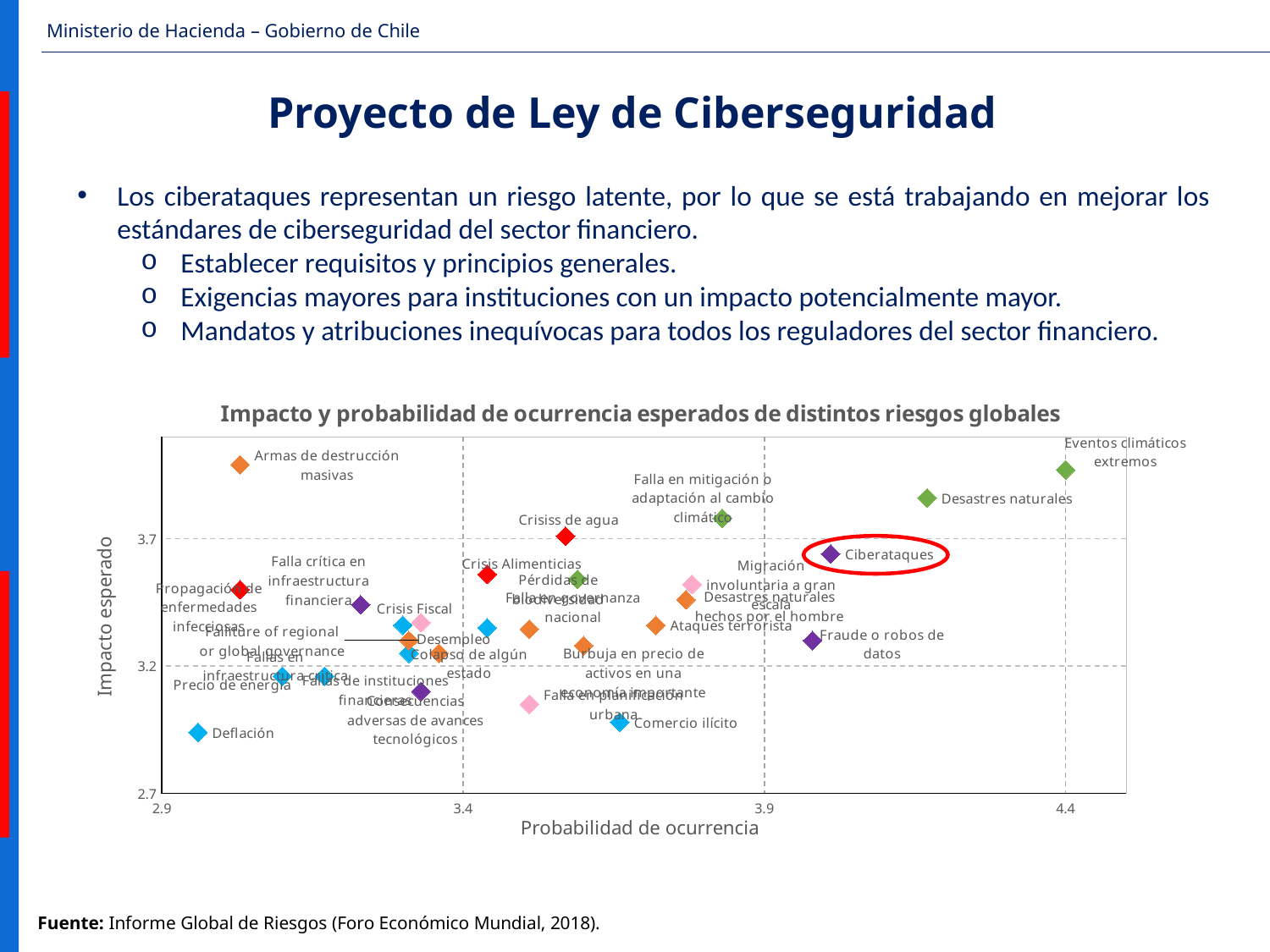
Is the probability of occurrence for Ciberataques greater or less than 3.9? greater What kind of chart is shown on the slide? Scatter chart Is the expected impact for Ciberataques greater or less than 3.7? less Which has a higher expected impact, Ciberataques or Deflación? Ciberataques Which risk has the highest probability of occurrence (Probabilidad de ocurrencia) in the chart? Eventos climáticos extremos Is the expected impact for Desastres naturales greater or less than 3.7? greater Which risk has the lowest expected impact (Impacto esperado) in the chart? Deflación Which risk is highlighted with a red circle in the chart? Ciberataques Which has a higher probability of occurrence, Eventos climáticos extremos or Ciberataques? Eventos climáticos extremos What is the title of the chart? Impacto y probabilidad de ocurrencia esperados de distintos riesgos globales Which risk has the lowest probability of occurrence in the chart? Deflación